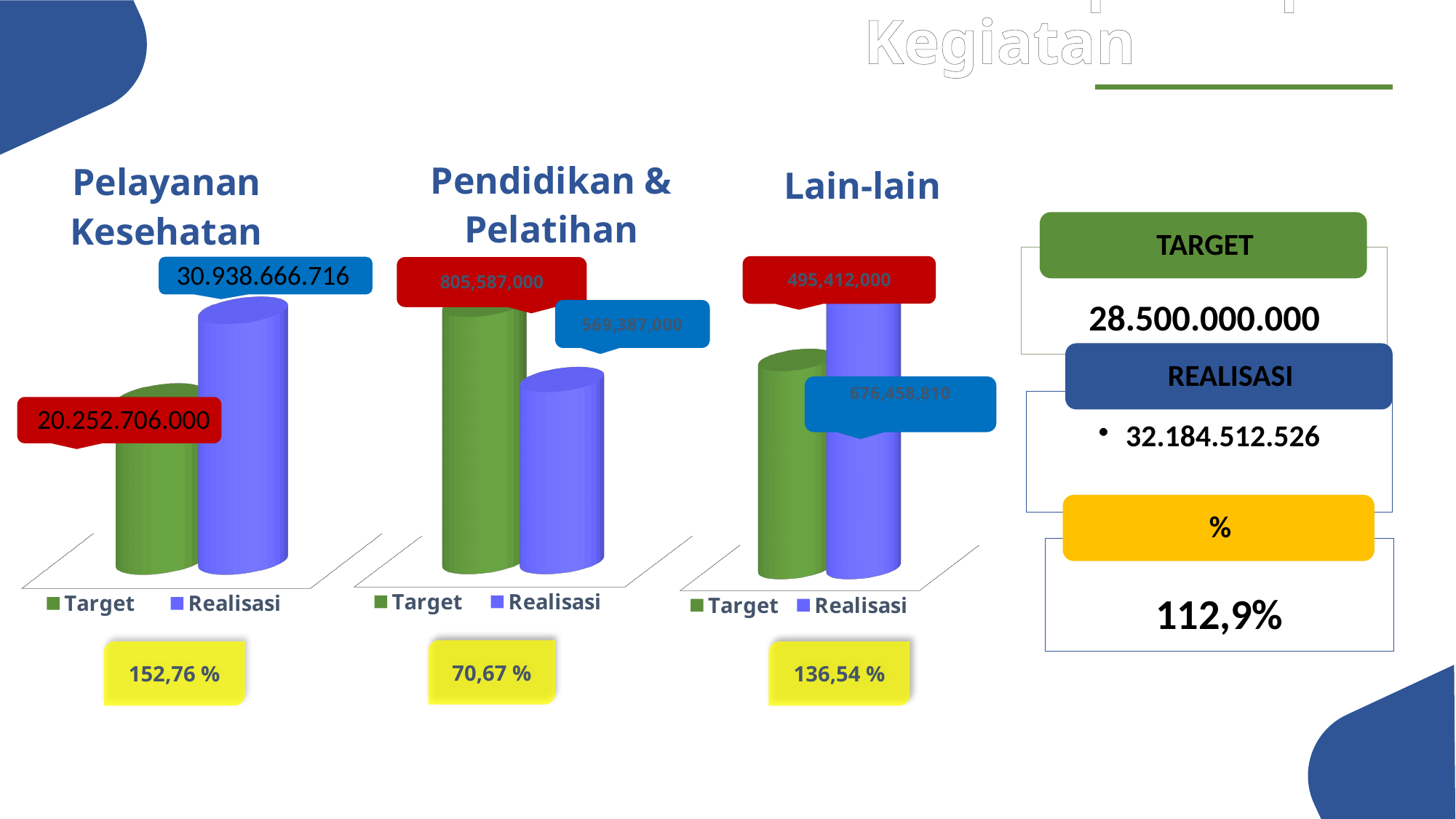
In the Pelayanan Kesehatan chart, what is the value of the Target bar? 20.252.706.000 In the Lain-lain chart, what is the value of the Target bar? 495,412,000 In the Pendidikan & Pelatihan chart, what is the value of the Target bar? 805,587,000 How many series does the legend of the Pelayanan Kesehatan chart list? 2 In the Pendidikan & Pelatihan chart, what is the value of the Realisasi bar? 569,387,000 In the Pelayanan Kesehatan chart, what is the value of the Realisasi bar? 30.938.666.716 In the Lain-lain chart, what is the difference between the Realisasi and Target values? 181,046,810 In the Lain-lain chart, which bar is taller, Target or Realisasi? Realisasi In the Pendidikan & Pelatihan chart, which bar is taller, Target or Realisasi? Target What kind of chart is the Lain-lain chart? Bar chart In the Lain-lain chart, what is the value of the Realisasi bar? 676,458,810 In the Pendidikan & Pelatihan chart, what is the difference between the Target and Realisasi values? 236,200,000